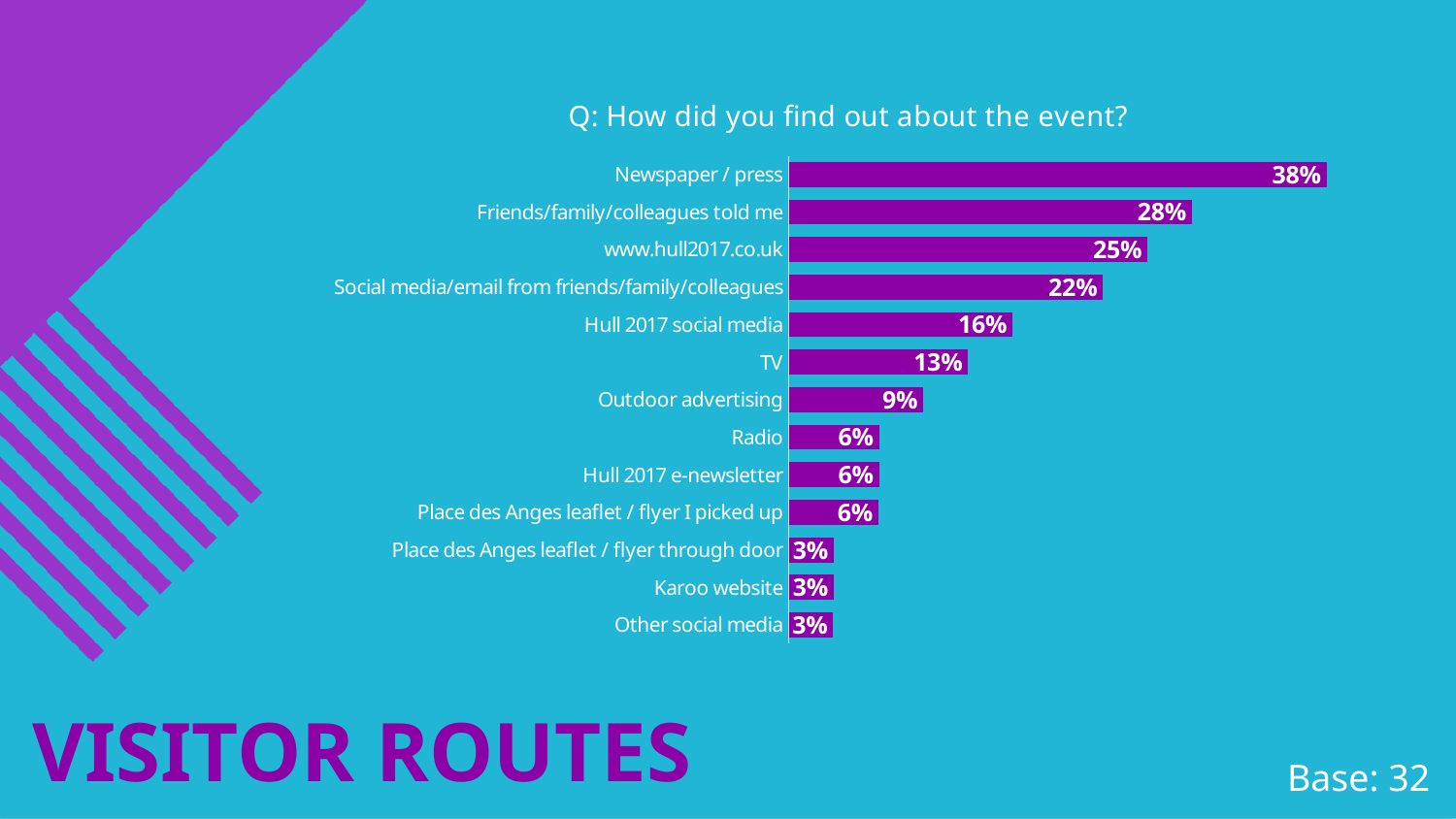
Which is larger, the value for Hull 2017 social media or the value for Radio? Hull 2017 social media What percentage of respondents found out about the event through Newspaper / press? 38% What kind of chart is shown on the slide? Bar chart What percentage found out about the event via TV? 13% What question is the chart based on, as shown in its title? Q: How did you find out about the event? How many categories are shown in the chart? 13 Which category has the highest value? Newspaper / press What is the value for Outdoor advertising? 9% What is the difference between www.hull2017.co.uk and Social media/email from friends/family/colleagues? 3% What is the value for Hull 2017 social media? 16% What is the difference between Newspaper / press and Friends/family/colleagues told me? 10% Which is larger, the value for TV or the value for Outdoor advertising? TV